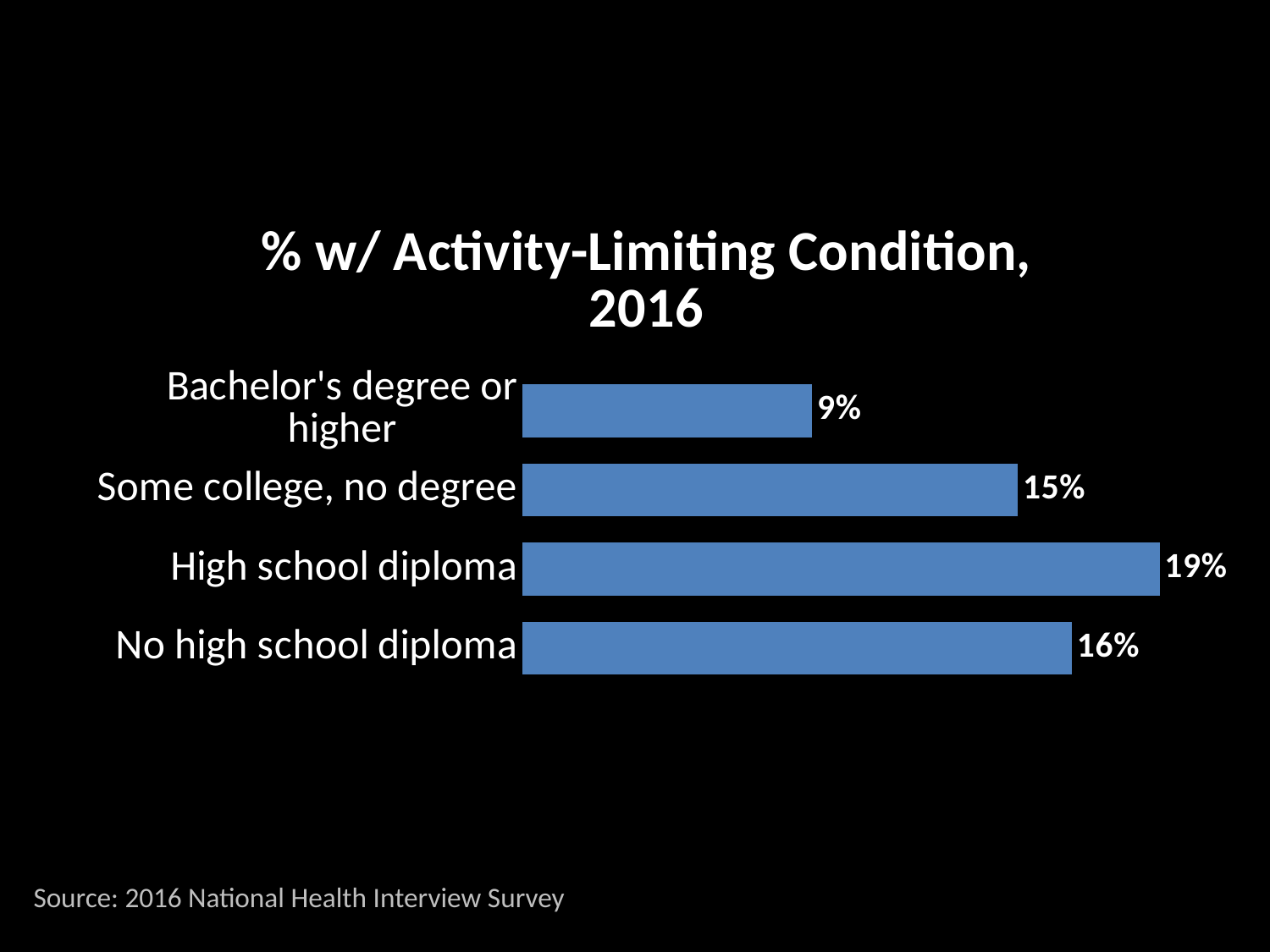
How many education categories are shown in the chart? 4 What type of chart is shown on the slide? Bar chart What is the value for 'No high school diploma'? 16% What is the value for 'Some college, no degree'? 15% What percentage of people with a Bachelor's degree or higher have an activity-limiting condition? 9% What is the title of the chart? % w/ Activity-Limiting Condition, 2016 Which education category has the lowest percentage with an activity-limiting condition? Bachelor's degree or higher What is the value for 'High school diploma'? 19% What is the difference in percentage points between 'High school diploma' and 'Bachelor's degree or higher'? 10 percentage points What is the difference between 'No high school diploma' and 'Some college, no degree'? 1 percentage point Which education category has the highest percentage with an activity-limiting condition? High school diploma Which is larger: the value for 'No high school diploma' or for 'Some college, no degree'? No high school diploma